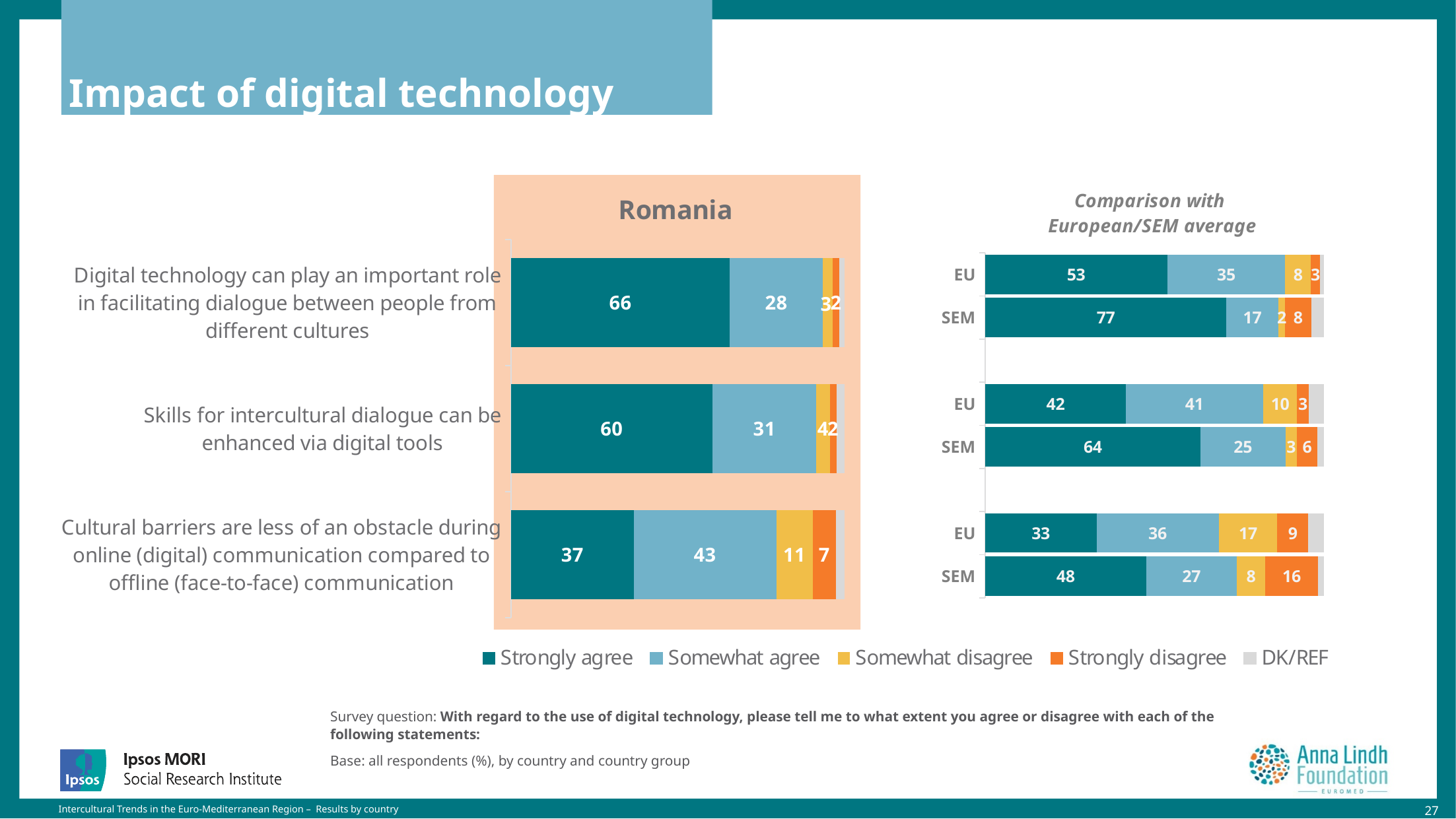
In the Romania chart, what percentage strongly agree that digital technology can play an important role in facilitating dialogue between people from different cultures? 66 How many series does the legend list? 5 In the Romania chart, which statement has the lowest 'Strongly agree' value? Cultural barriers are less of an obstacle during online (digital) communication compared to offline (face-to-face) communication In the Comparison with European/SEM average chart, what is the EU 'Somewhat disagree' value for the third statement (cultural barriers are less of an obstacle online)? 17 In the Romania chart, what is the 'Somewhat agree' value for 'Skills for intercultural dialogue can be enhanced via digital tools'? 31 In the Romania chart, what is the difference between the 'Strongly agree' values for the first statement (66) and the third statement (37)? 29 In the Comparison with European/SEM average chart, what is the difference between the SEM (64) and EU (42) 'Strongly agree' values for the second statement (skills for intercultural dialogue can be enhanced via digital tools)? 22 In the Romania chart, for the third statement, which is larger: 'Strongly agree' or 'Somewhat agree'? Somewhat agree In the Romania chart, what is the 'Strongly disagree' value for 'Cultural barriers are less of an obstacle during online (digital) communication compared to offline (face-to-face) communication'? 7 What kind of chart is the Romania chart? Stacked bar chart In the Comparison with European/SEM average chart, what is the SEM 'Strongly agree' value for the first statement (digital technology can play an important role in facilitating dialogue)? 77 How many statements are shown in the Romania chart? 3